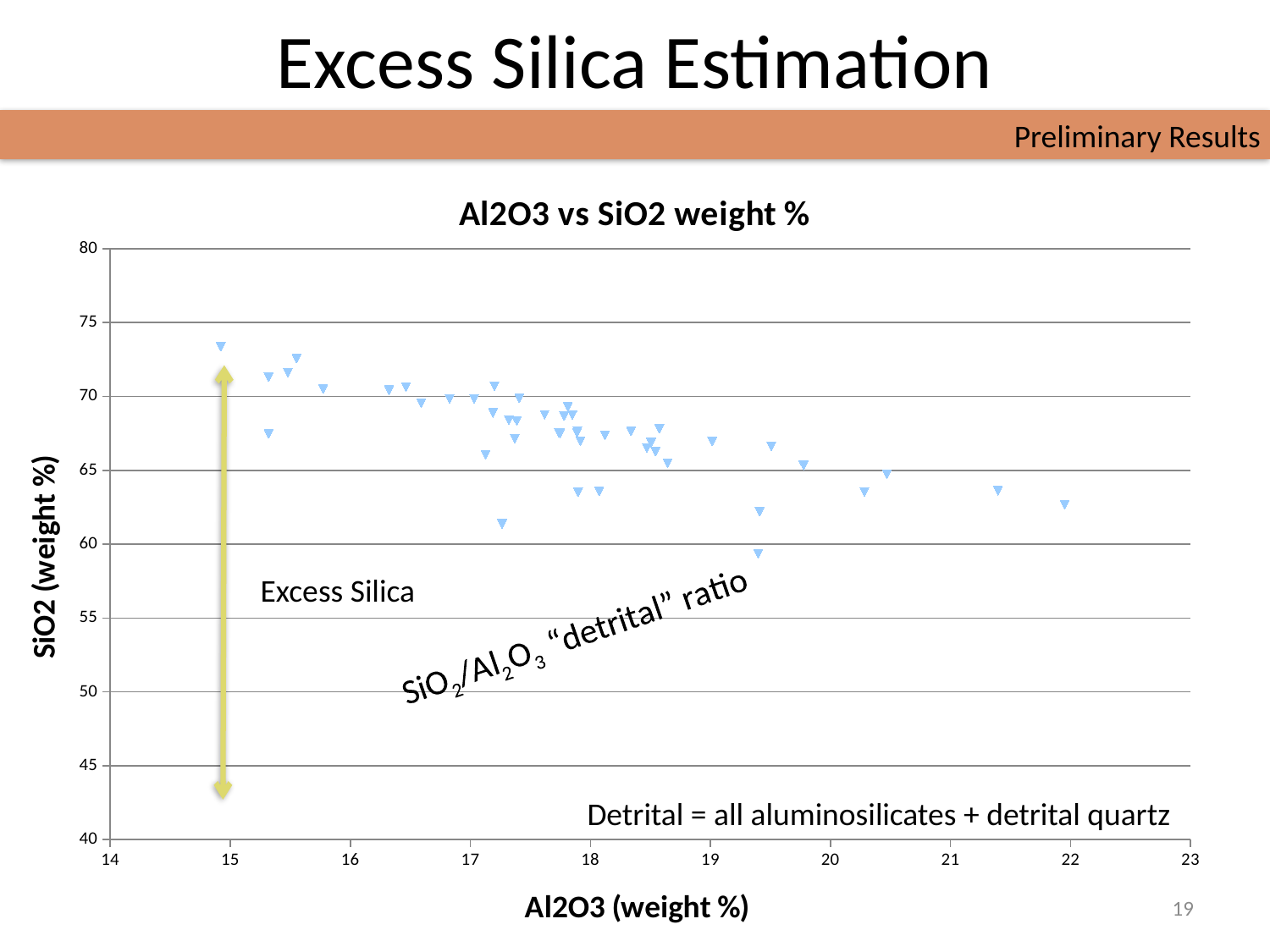
What is the label on the vertical axis of the chart? SiO2 (weight %) Is the SiO2 value of the point at about 21.4 Al2O3 greater or less than 65? less Is the highest SiO2 value plotted on the chart greater or less than 75? less What is the title of the chart? Al2O3 vs SiO2 weight % What kind of chart is shown on the slide? Scatter chart Is the SiO2 value of the point with the highest Al2O3 (near 22) greater or less than 65? less What is the maximum value shown on the vertical axis of the chart? 80 How many data series are plotted on the chart? 1 As Al2O3 (weight %) increases along the x axis, do the SiO2 values generally rise or fall? Fall What is the minimum value shown on the horizontal axis of the chart? 14